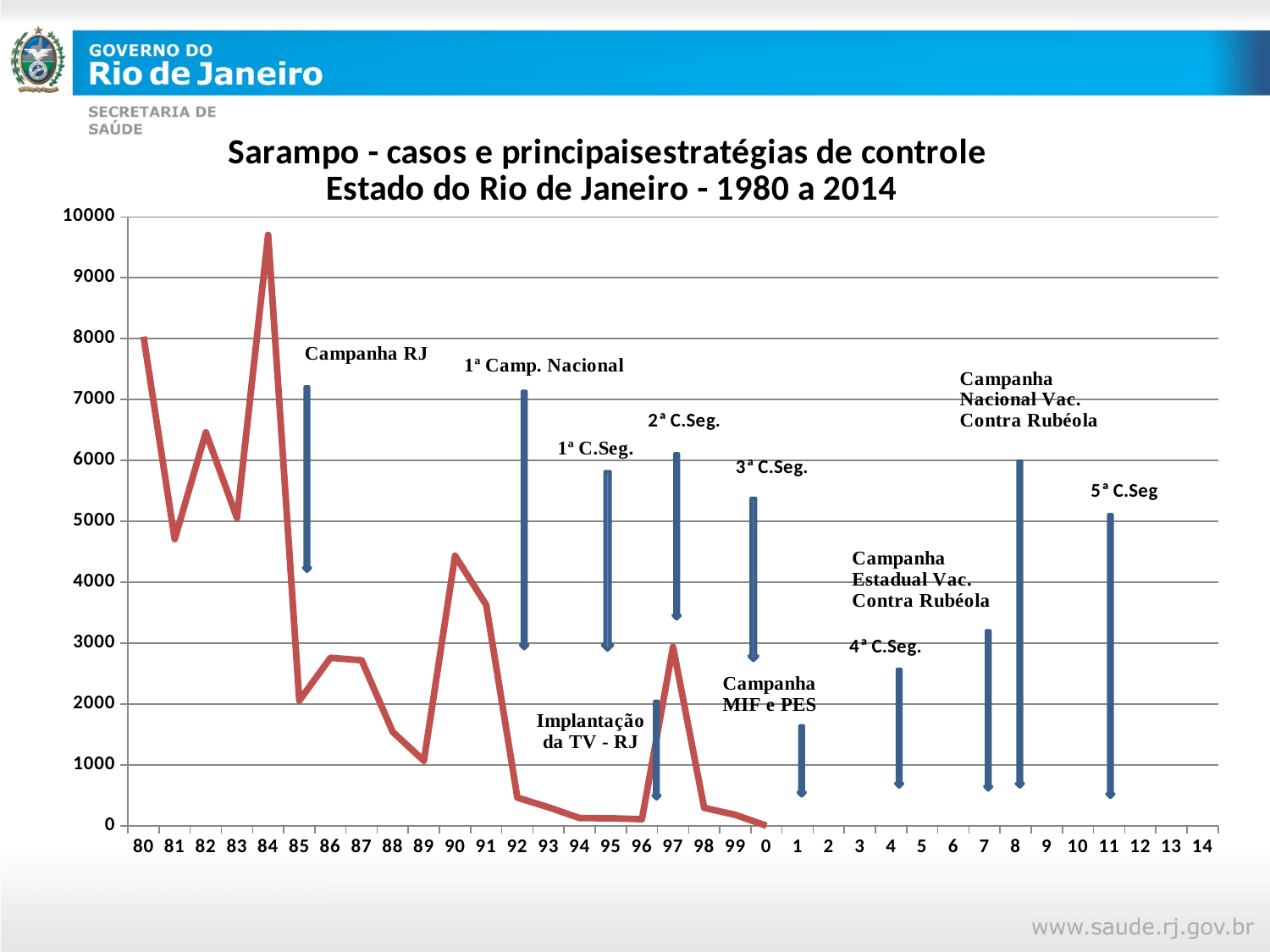
Which control strategy is annotated at year 85? Campanha RJ What kind of chart is shown on the slide? line chart Is the value for 86 greater or less than 3000? less Is the value for 90 greater or less than 4000? greater Does the line rise or fall between 84 and 85? fall Is the value for 82 greater or less than 6000? greater In which year does the line reach its highest value? 84 What is the title of the chart? Sarampo - casos e principaisestratégias de controle Estado do Rio de Janeiro - 1980 a 2014 Which year has the larger value, 90 or 91? 90